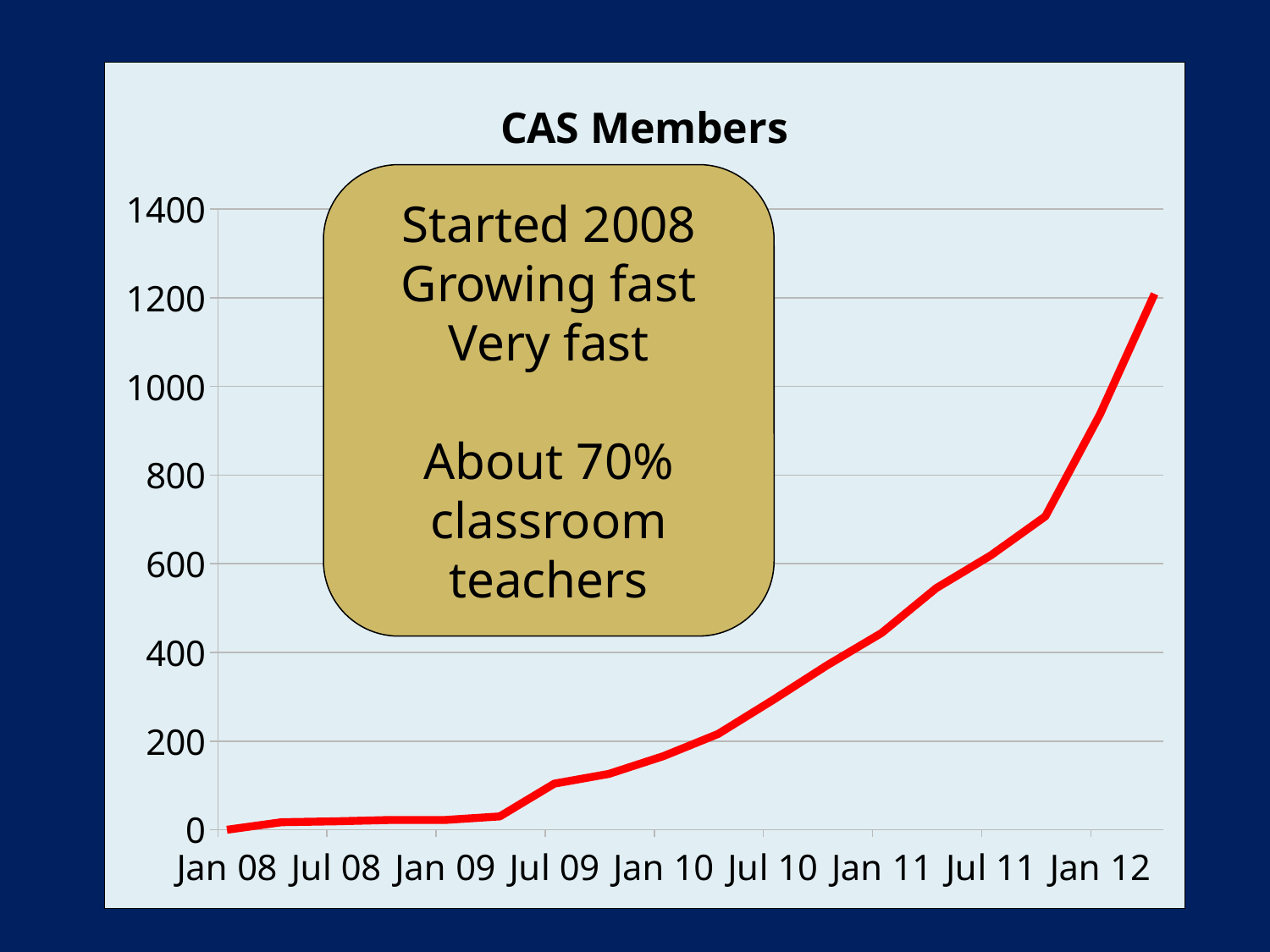
What is the title of the chart? CAS Members Is the value for Jan 08 greater or less than 200? less How many labels are shown on the x axis? 9 Is the value for Jan 11 greater or less than 600? less At which x-axis label is the number of CAS members highest? Jan 12 Is the value for Jul 10 greater or less than 400? less What kind of chart is shown on the slide? line chart Do the values rise or fall from Jan 08 to Jan 12? rise Which is larger, the value for Jan 10 or the value for Jan 11? Jan 11 At which x-axis label is the number of CAS members lowest? Jan 08